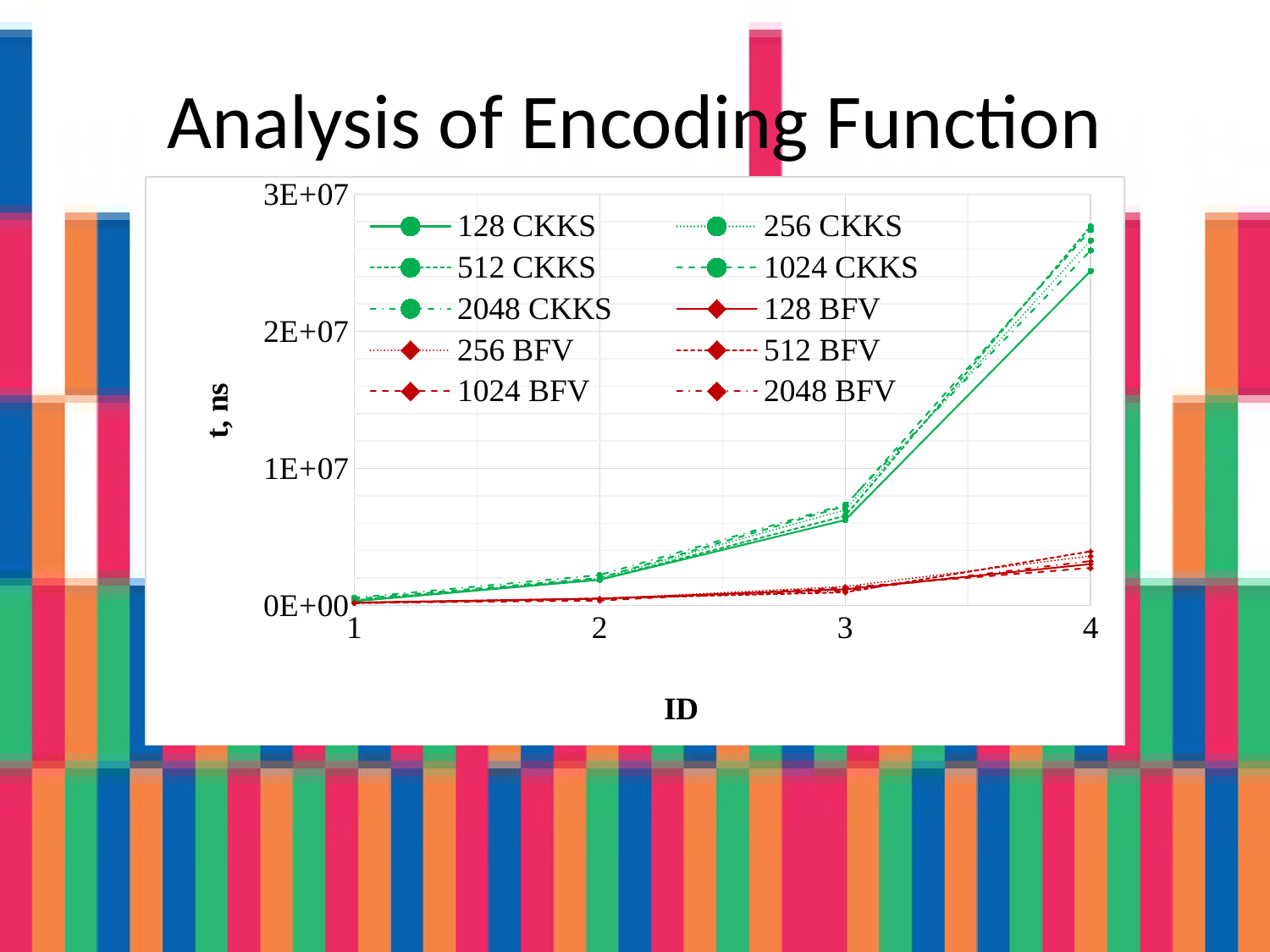
Do the values for 128 CKKS rise or fall as ID increases from 1 to 4? rise At ID 3, which is larger: the value for 2048 CKKS or the value for 2048 BFV? 2048 CKKS How many series does the legend list? 10 What is the label of the y axis? t, ns Do the values for 2048 BFV rise or fall as ID increases from 1 to 4? rise Is the value for 128 BFV at ID 4 greater or less than 1E+07? less Is the value for 128 CKKS at ID 4 greater or less than 2E+07? greater What kind of chart is shown on the slide? line chart At ID 4, which is larger: the value for 128 CKKS or the value for 128 BFV? 128 CKKS What is the title of the slide containing the chart? Analysis of Encoding Function Is the value for 128 CKKS at ID 3 greater or less than 1E+07? less How many ID values are plotted along the x axis? 4